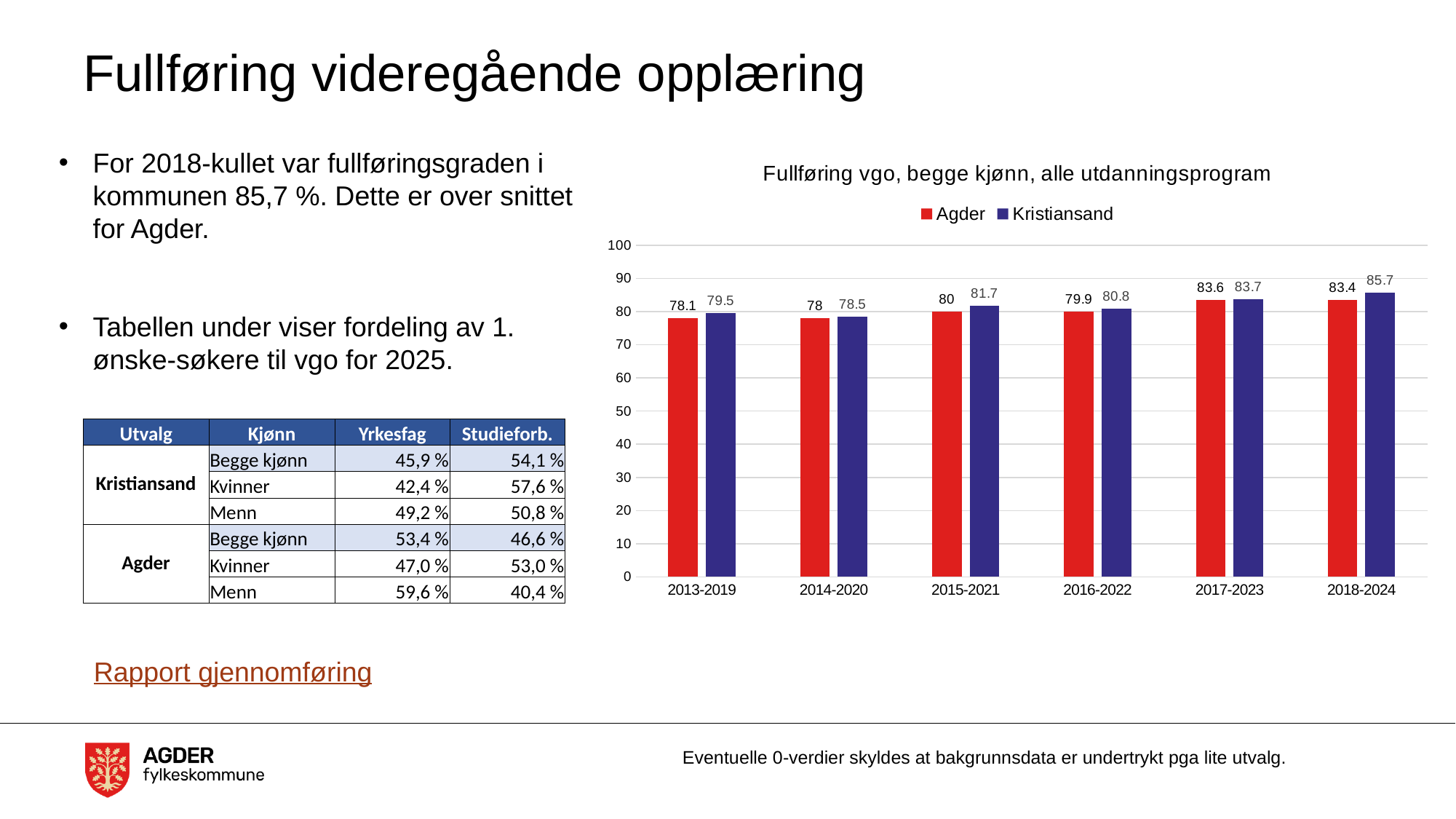
How many series does the legend list? 2 How many periods are shown on the x axis? 6 Which period has the lowest value for Agder? 2014-2020 Which period has the highest value for Kristiansand? 2018-2024 What is the value for Agder in 2017-2023? 83.6 What is the value for Kristiansand in 2018-2024? 85.7 Which is larger in 2015-2021, Agder or Kristiansand? Kristiansand Is the value for Agder in 2013-2019 greater or less than 80? less What is the title of the chart? Fullføring vgo, begge kjønn, alle utdanningsprogram What is the value for Agder in 2014-2020? 78 What is the difference between Kristiansand and Agder in 2018-2024? 2.3 What kind of chart is shown? bar chart